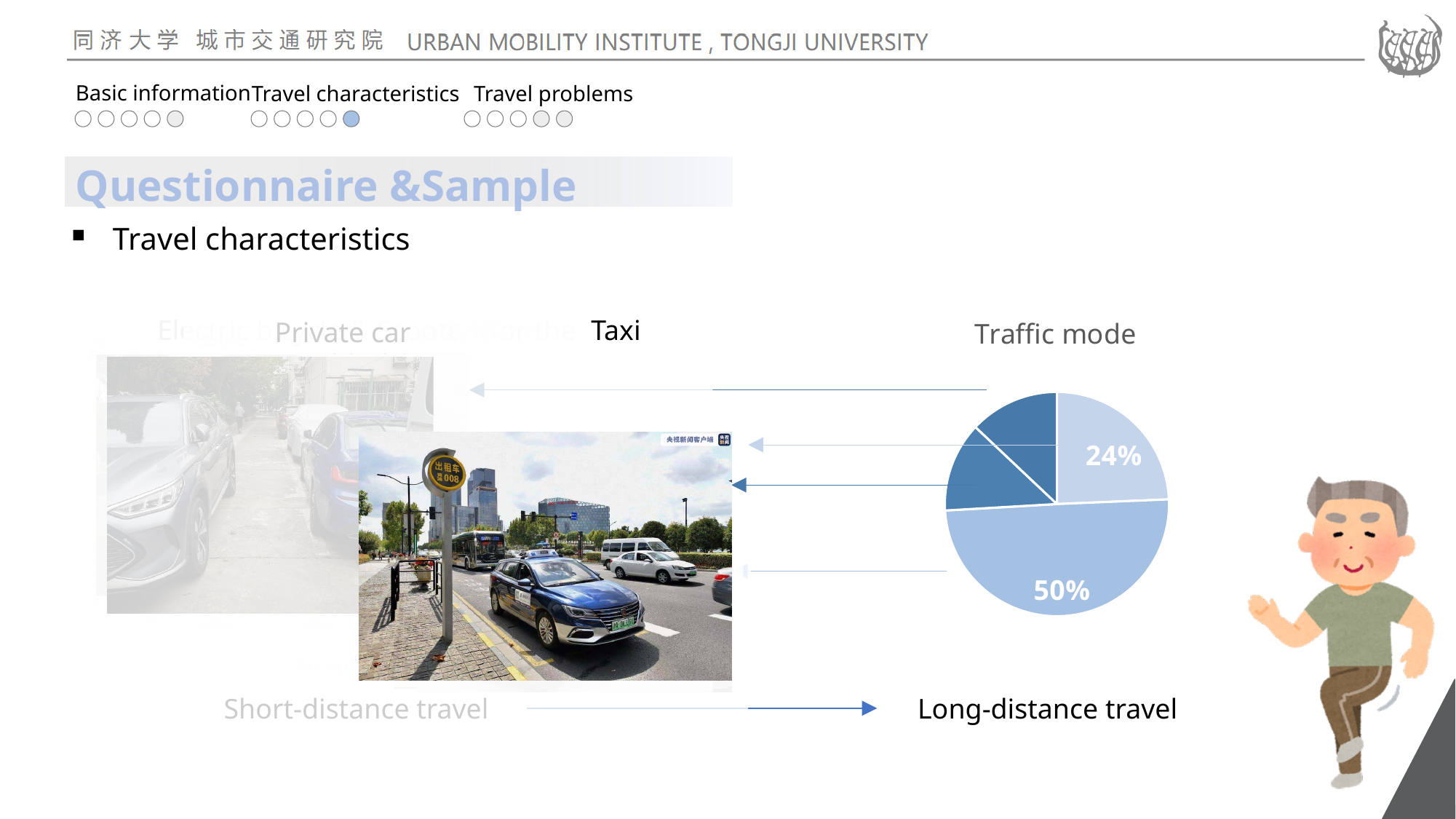
How many slices of the Traffic mode pie chart have a percentage label printed on them? 2 Is the largest slice of the Traffic mode pie chart greater or less than 40%? greater What is the difference in percentage points between the two labelled slices (50% and 24%) of the Traffic mode pie chart? 26 percentage points What kind of chart is shown under the title "Traffic mode"? pie chart In the Traffic mode pie chart, which labelled slice is larger, the 24% slice or the 50% slice? the 50% slice What is the title of the pie chart on the slide? Traffic mode What do the two labelled slices of the Traffic mode pie chart add up to? 74% How many slices does the Traffic mode pie chart have? 4 What share of the Traffic mode pie does the largest labelled slice represent? 50% What is the largest percentage printed on the Traffic mode pie chart? 50% Is the 24% slice of the Traffic mode pie chart greater or less than 30%? less What is the smaller of the two percentages printed on the Traffic mode pie chart? 24%